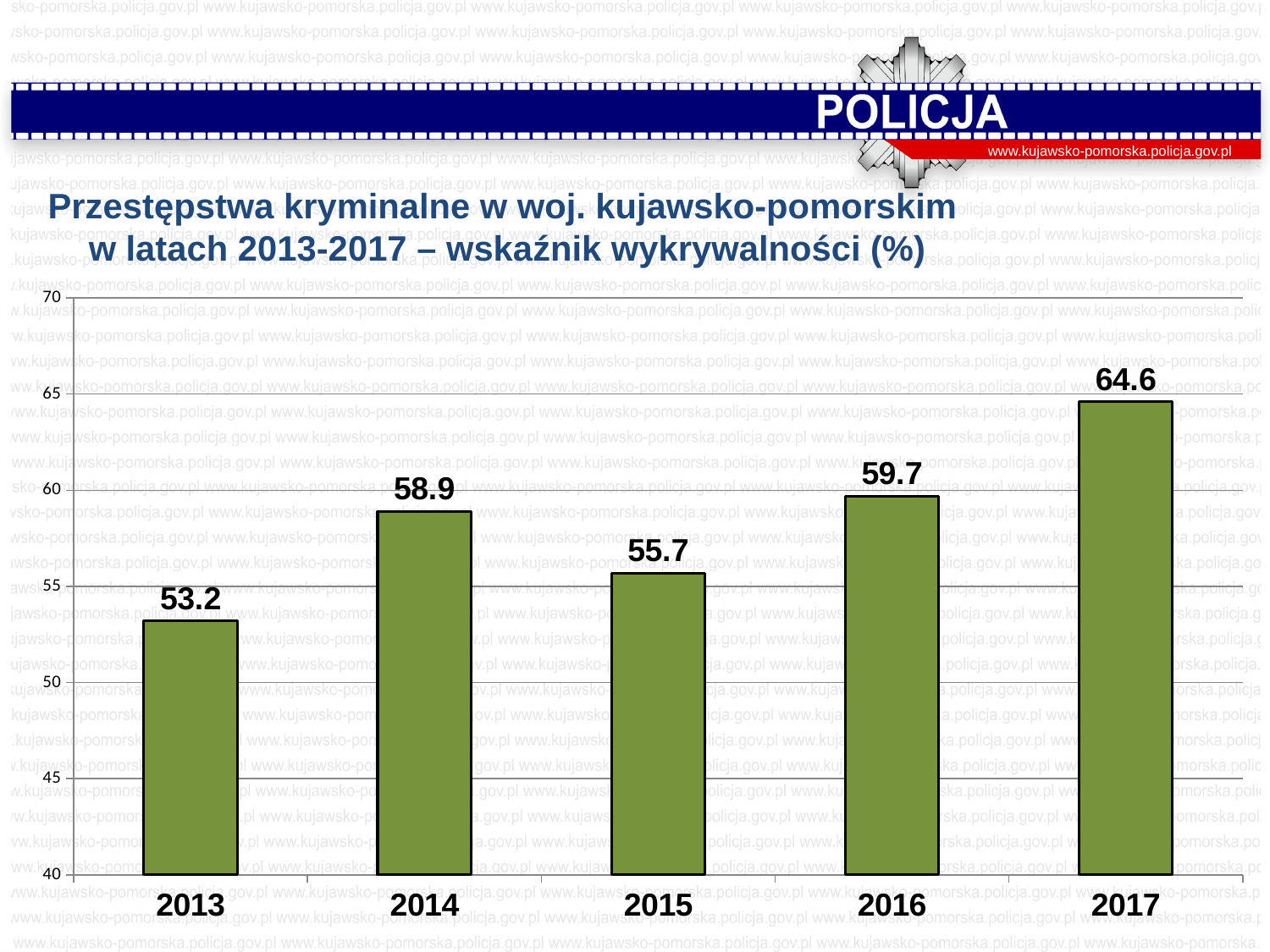
How many years are shown on the x axis? 5 What is the detection rate value shown for 2017? 64.6 What is the title of the chart? Przestępstwa kryminalne w woj. kujawsko-pomorskim w latach 2013-2017 – wskaźnik wykrywalności (%) Is the value for 2015 greater or less than 60? less Which is larger, the value for 2014 or the value for 2016? 2016 What is the difference between the values for 2017 and 2016? 4.9 Which year has the lowest value? 2013 What is the difference between the values for 2014 and 2015? 3.2 What is the value shown for 2013? 53.2 What is the value shown for 2015? 55.7 What kind of chart is shown on the slide? bar chart Which year has the highest value? 2017